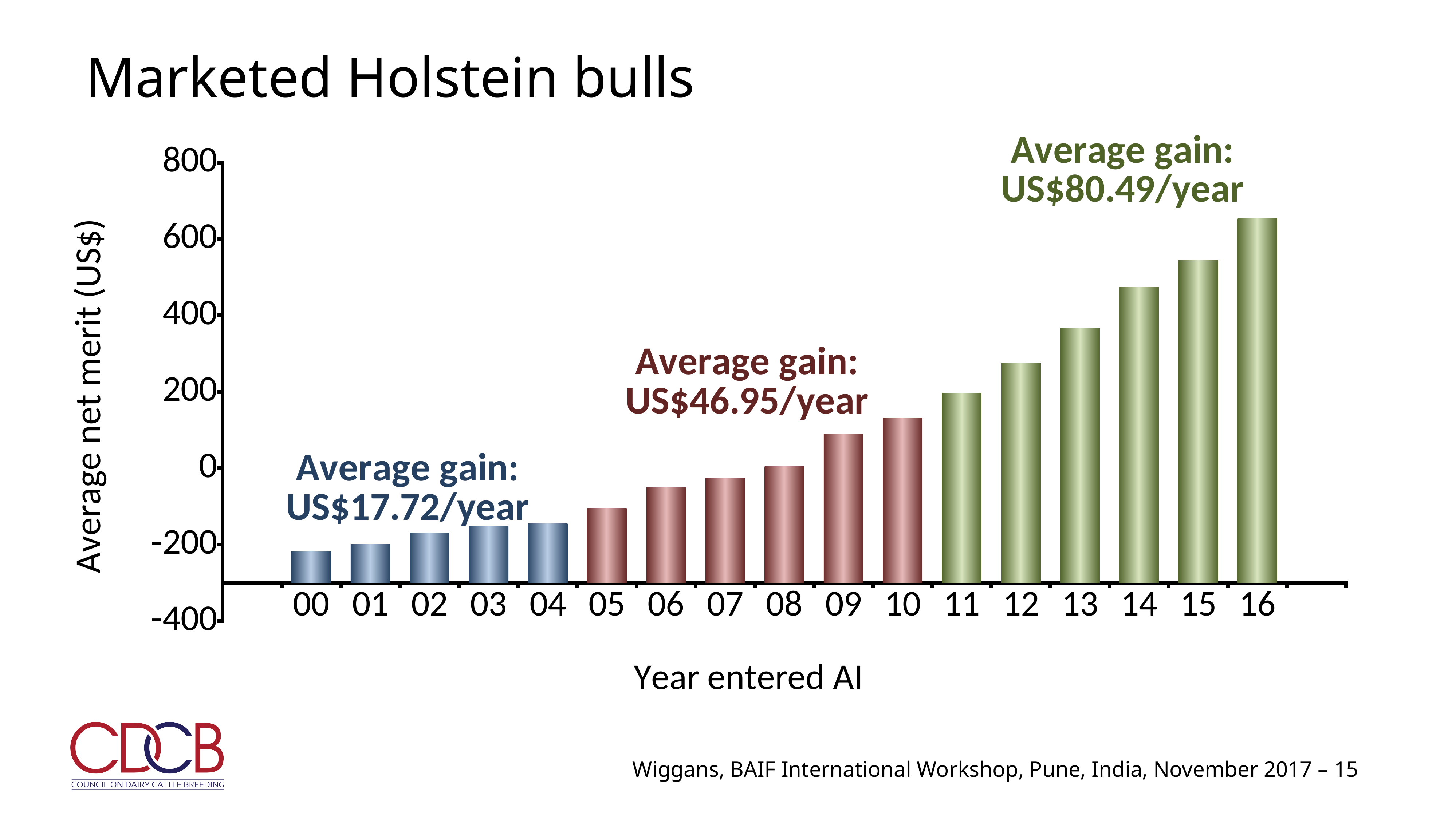
Do the average net merit values rise or fall from year 00 to year 16? rise Is the average net merit for year 16 greater or less than 600? greater Is the average net merit for year 05 greater or less than 0? less Which year entered AI has the lowest average net merit? 00 Which has the larger average net merit, year 10 or year 05? 10 What kind of chart is shown on the slide? bar chart Is the average net merit for year 14 greater or less than 400? greater Which year entered AI has the highest average net merit? 16 How many years (bars) are plotted on the x axis? 17 What average gain per year is stated for the blue bars (years 00 to 04)? US$17.72/year What average gain per year is stated for the green bars (years 11 to 16)? US$80.49/year